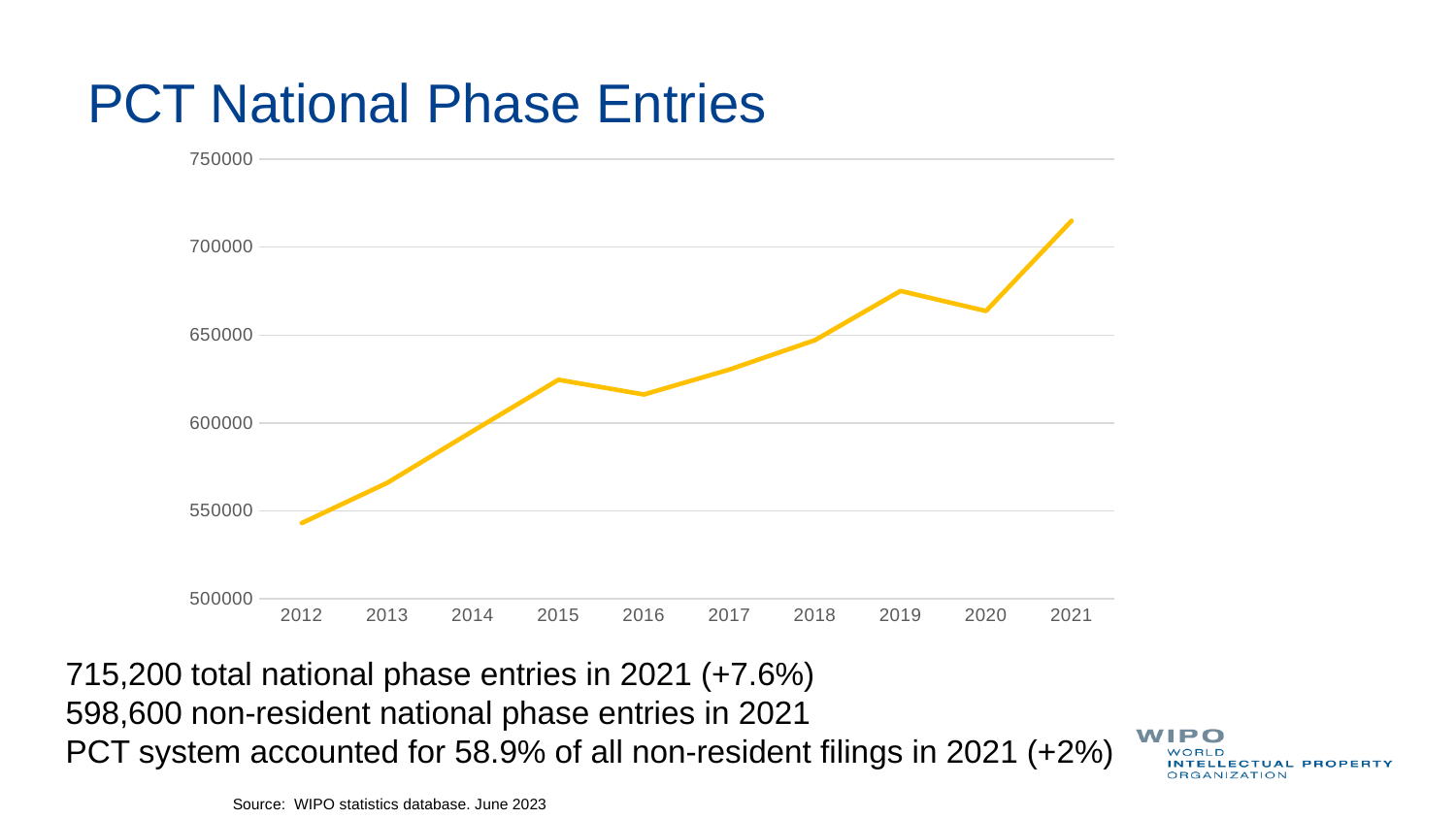
Is the value for 2019 greater or less than 650000? greater Is the value for 2012 greater or less than 550000? less What is the title of the chart? PCT National Phase Entries What kind of chart is shown on the slide? Line chart Which year has the lowest number of PCT national phase entries? 2012 Which year has more PCT national phase entries, 2019 or 2020? 2019 Is the value for 2015 greater or less than 600000? greater Do PCT national phase entries generally rise or fall from 2012 to 2021? Rise According to the slide, how many total national phase entries were there in 2021? 715,200 Which year has the highest number of PCT national phase entries? 2021 How many years are plotted on the x axis of the chart? 10